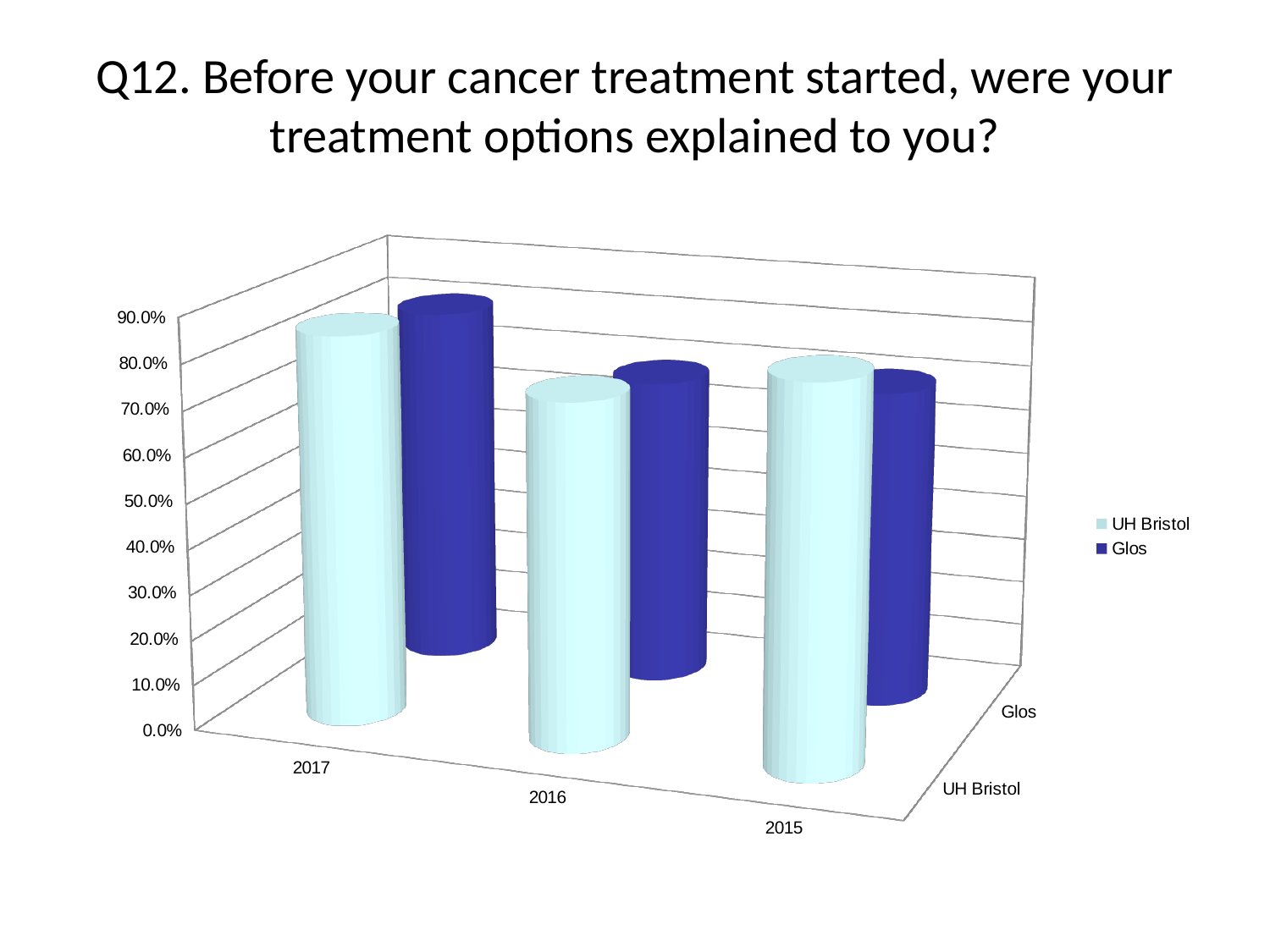
How many year categories are shown on the x axis? 3 For UH Bristol, is the value for 2017 larger or smaller than the value for 2016? larger What kind of chart is shown on the slide? bar chart For the Glos series, which year has the highest value? 2017 How many series does the legend list? 2 Is the Glos value for 2015 greater or less than 50%? greater Is the UH Bristol value for 2016 greater or less than 50%? greater Which series are listed in the legend? UH Bristol and Glos For the UH Bristol series, which year has the highest value? 2017 For the UH Bristol series, which year has the lowest value? 2016 Which years are shown on the x axis? 2017, 2016, 2015 For Glos, is the value for 2017 larger or smaller than the value for 2016? larger